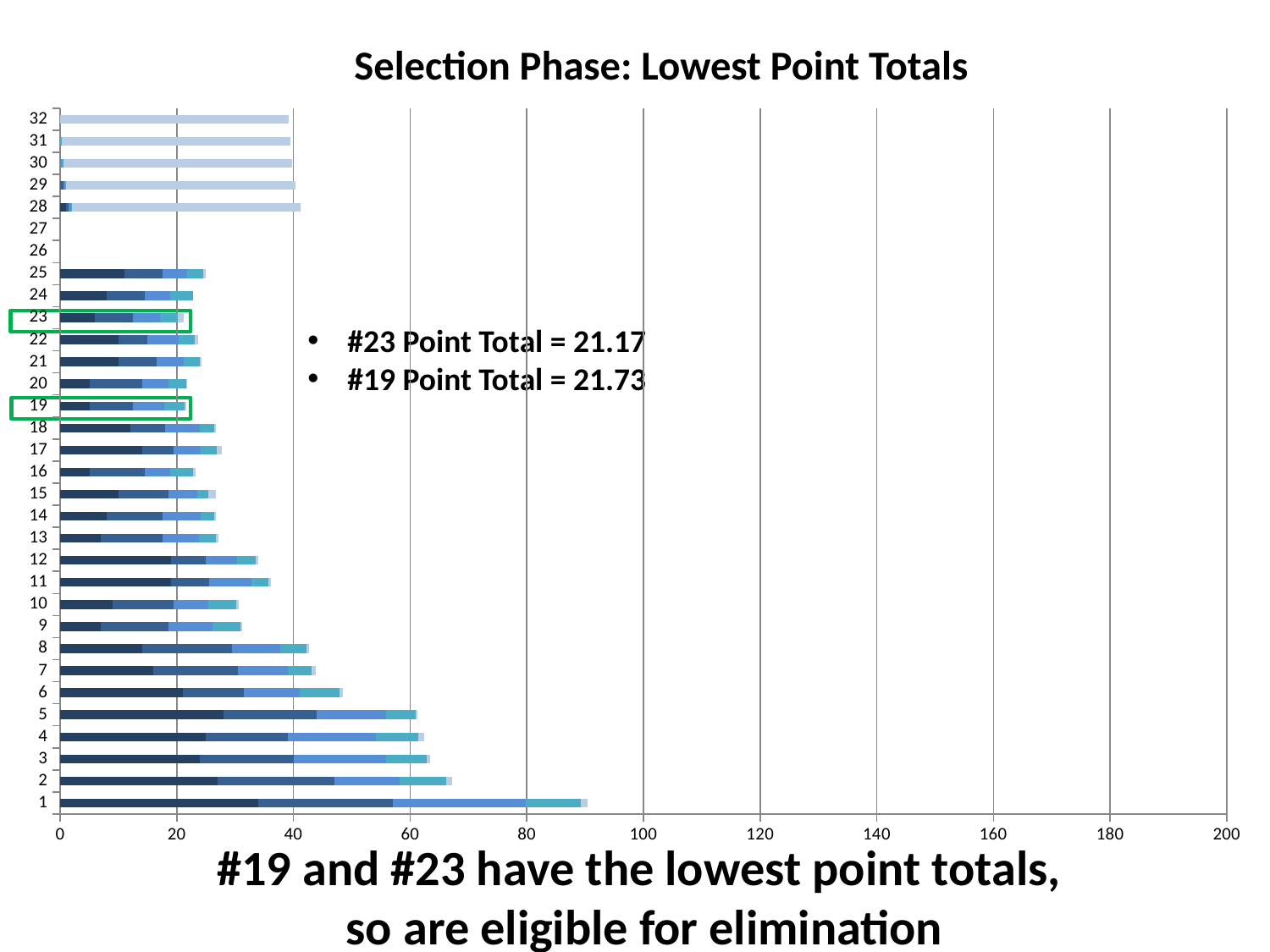
Which has the larger point total, #19 or #23? #19 What is the difference between the point totals of #19 and #23? 0.56 Is the total bar length for category 12 greater or less than 40? less What is the point total for #23 according to the slide? 21.17 Is the total bar length for category 1 greater or less than 80? greater Which two categories are outlined with green boxes on the chart? 19 and 23 How many categories are listed on the vertical axis of the chart? 32 Is the total bar length for category 6 greater or less than 40? greater What is the title of the chart? Selection Phase: Lowest Point Totals What kind of chart is shown on the slide? bar chart What is the point total for #19 according to the slide? 21.73 Which category has the longest bar in the chart? 1